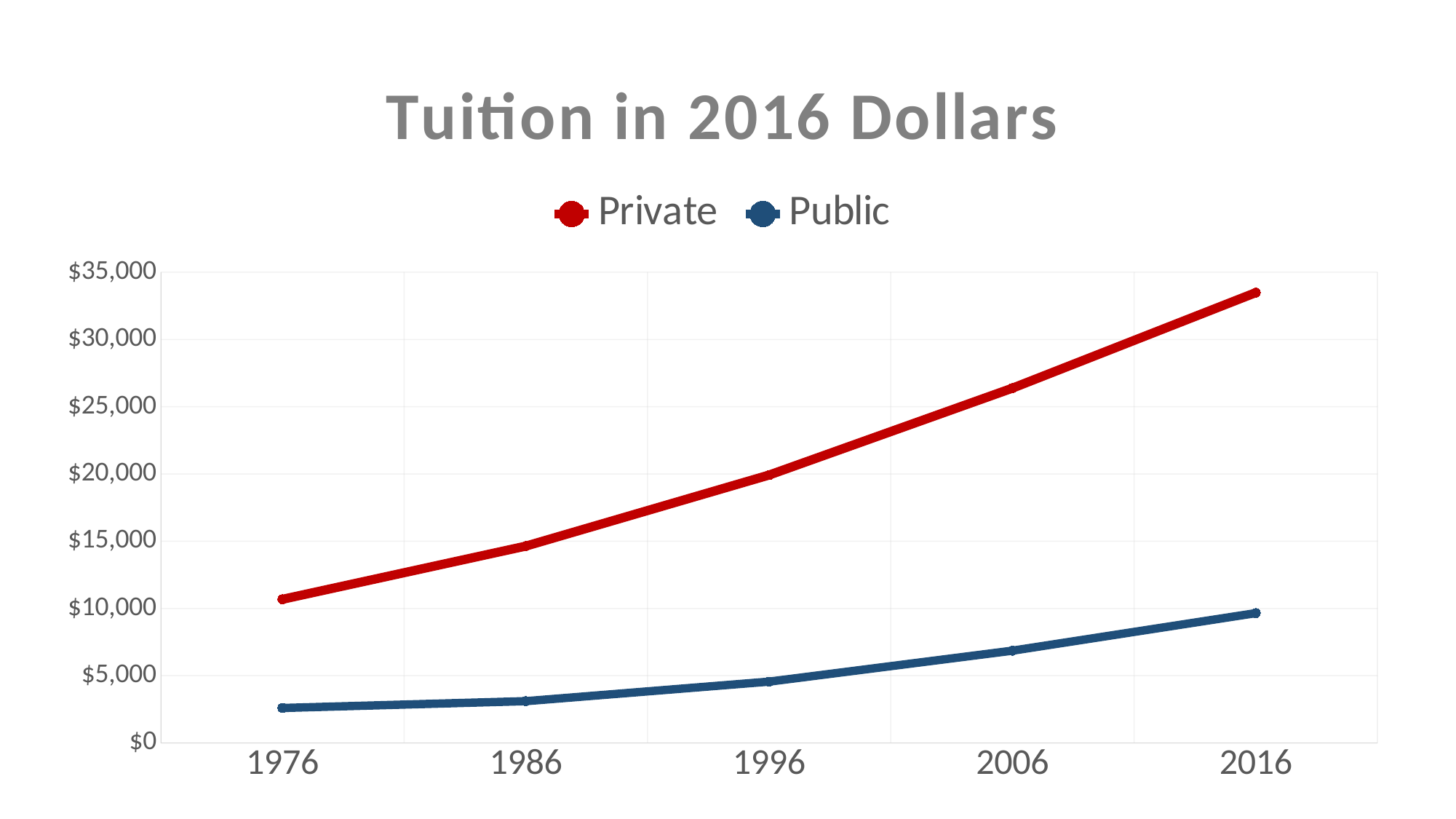
How many years are plotted along the x axis? 5 What kind of chart is shown on the slide? line chart How many series does the legend list? 2 Is the value for Private in 2016 greater or less than $30,000? greater In which year is the Public tuition lowest? 1976 Does the Private tuition rise or fall from 1976 to 2016? rise Does the Public tuition rise or fall from 1976 to 2016? rise Is the value for Public in 1976 greater or less than $5,000? less In which year is the Private tuition highest? 2016 Which series is drawn in red? Private What is the title of the chart? Tuition in 2016 Dollars Which series has the higher value in 2006, Private or Public? Private